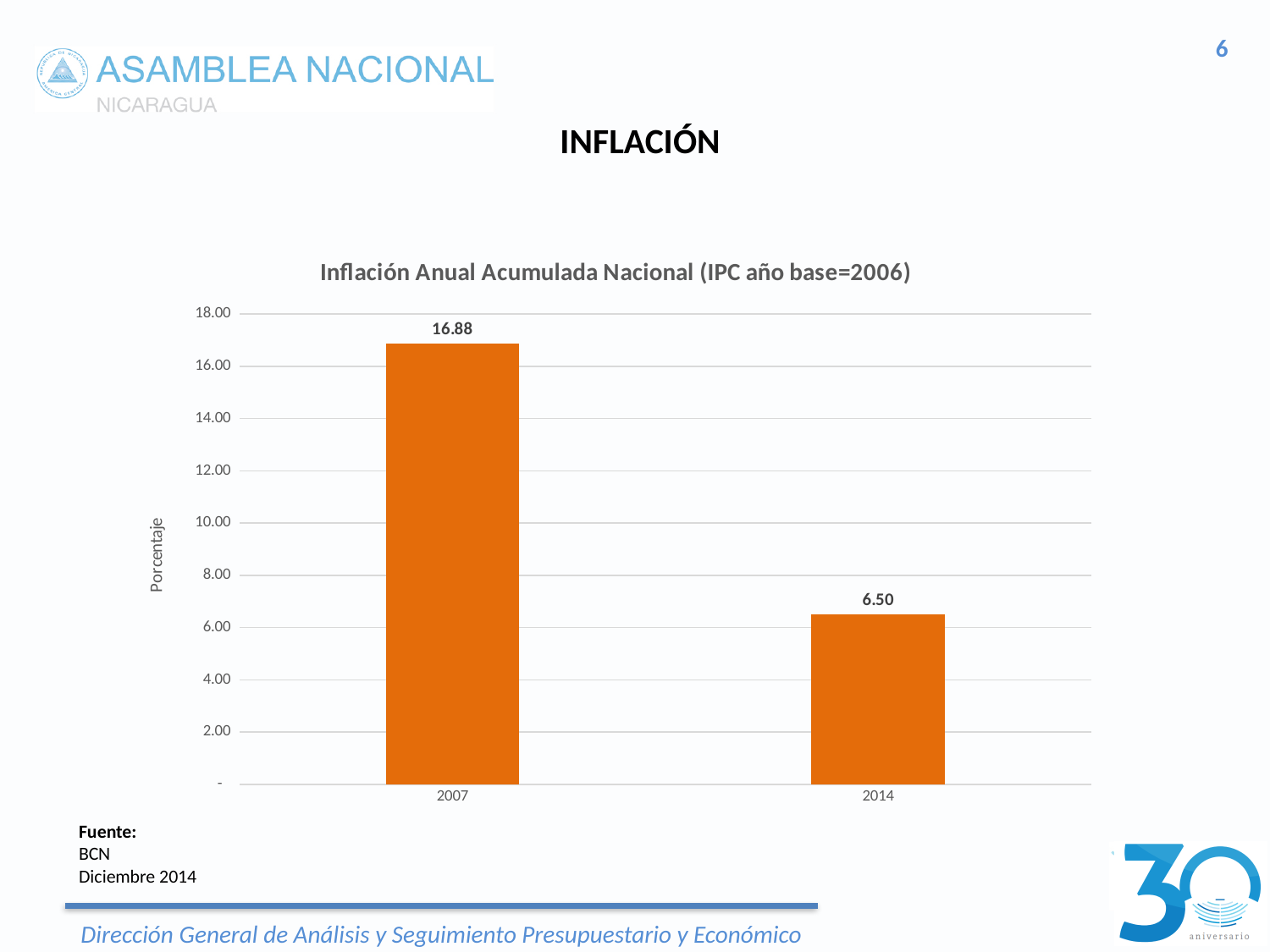
How many years (categories) are plotted in the chart? 2 What is the inflation value shown for 2007? 16.88 What is the title of the chart? Inflación Anual Acumulada Nacional (IPC año base=2006) Do the values rise or fall from 2007 to 2014? Fall What kind of chart is shown on the slide? Bar chart Which year has the higher inflation value? 2007 Is the value for 2007 greater or less than 16.00? greater Which year has the lower inflation value? 2014 What is the inflation value shown for 2014? 6.50 What is the label on the vertical axis of the chart? Porcentaje Is the value for 2014 greater or less than 8.00? less What is the difference between the 2007 and 2014 inflation values? 10.38